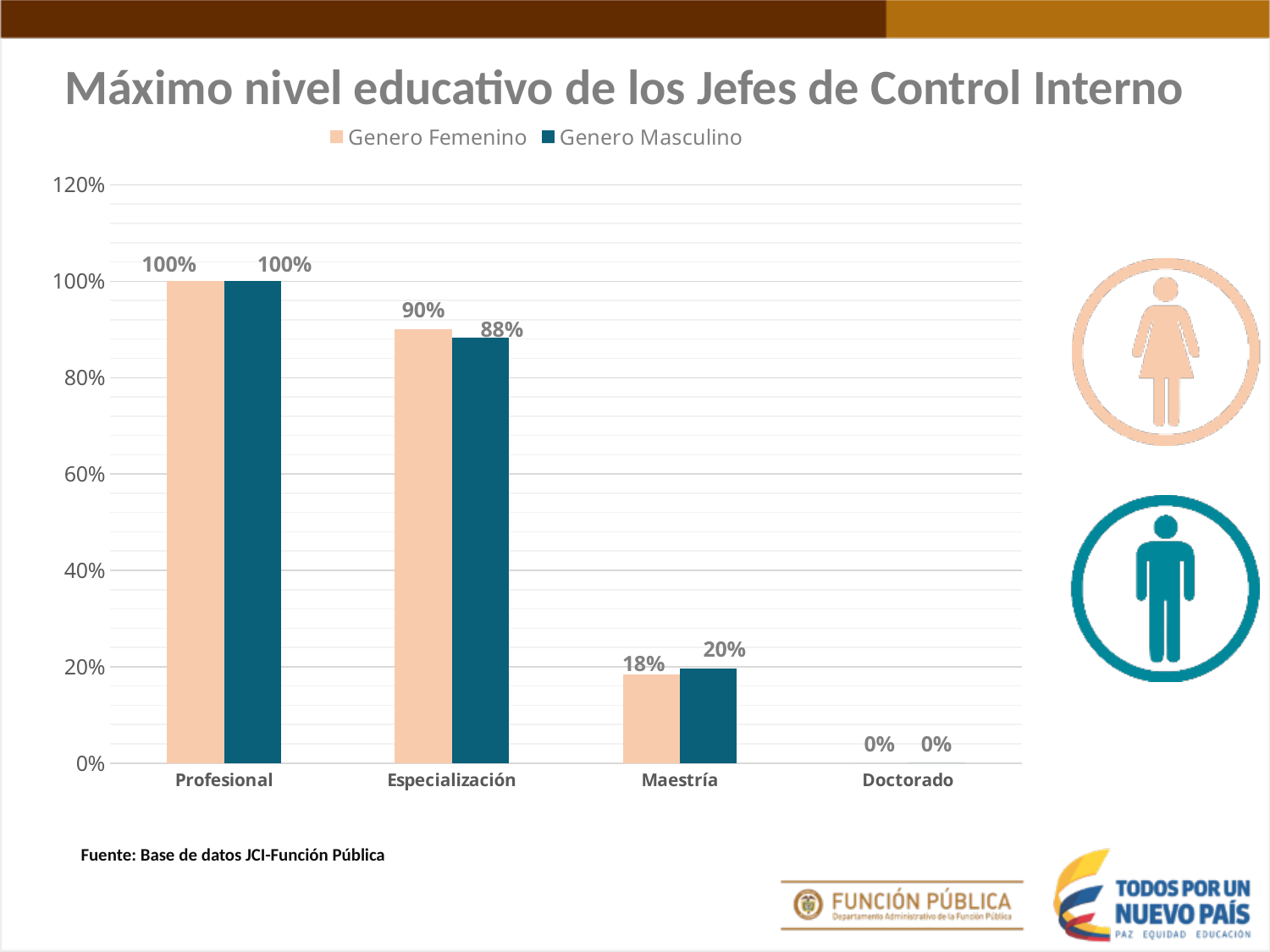
In the Maestría category, which series has the larger value, Genero Femenino or Genero Masculino? Genero Masculino How many series does the legend list? 2 What is the value for Genero Masculino in the Especialización category? 88% What is the value for Genero Femenino in the Especialización category? 90% How many categories are shown on the x axis? 4 What kind of chart is shown on the slide? Bar chart Which category has the lowest value for Genero Femenino? Doctorado Do the values for Genero Femenino rise or fall from Profesional to Doctorado? Fall What is the value for Genero Masculino in the Maestría category? 20% What is the difference between Genero Femenino and Genero Masculino in the Especialización category? 2% What is the title of the chart? Máximo nivel educativo de los Jefes de Control Interno Which category has the highest value for Genero Masculino? Profesional